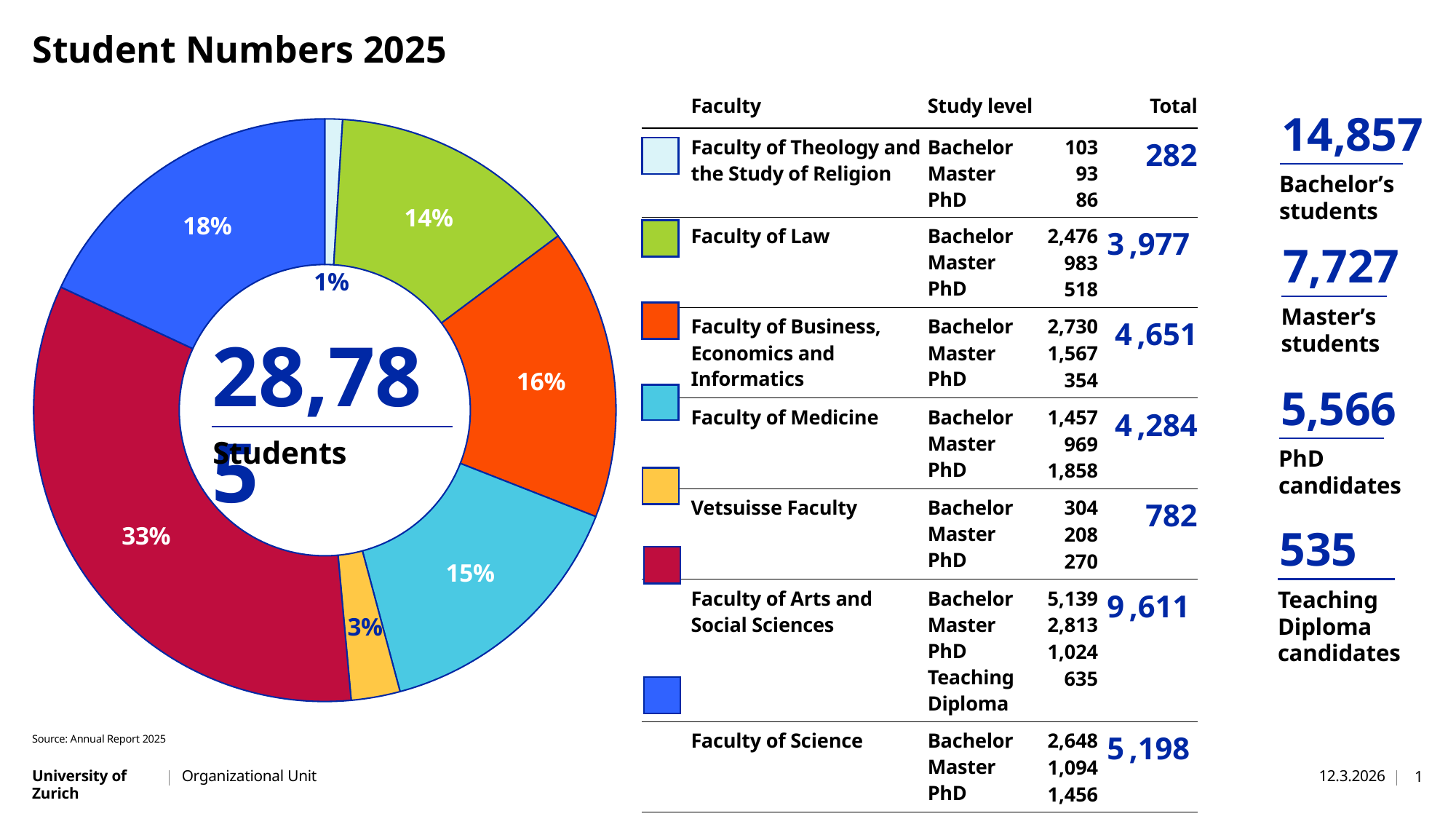
What percentage share does the Vetsuisse Faculty slice show in the donut chart? 3% What kind of chart is shown on the left of the slide? pie chart (donut) What percentage share does the Faculty of Science slice show in the donut chart? 18% How many slices does the donut chart have? 7 In the donut chart, what is the difference in percentage points between the Faculty of Arts and Social Sciences slice and the Faculty of Science slice? 15 percentage points In the donut chart, which slice is larger: Faculty of Business, Economics and Informatics or Faculty of Medicine? Faculty of Business, Economics and Informatics Which faculty has the smallest slice in the donut chart? Faculty of Theology and the Study of Religion Which faculty has the largest slice in the donut chart? Faculty of Arts and Social Sciences What is the title of the slide containing the donut chart? Student Numbers 2025 What percentage share does the Faculty of Arts and Social Sciences slice show in the donut chart? 33% What colour is the largest slice of the donut chart? red